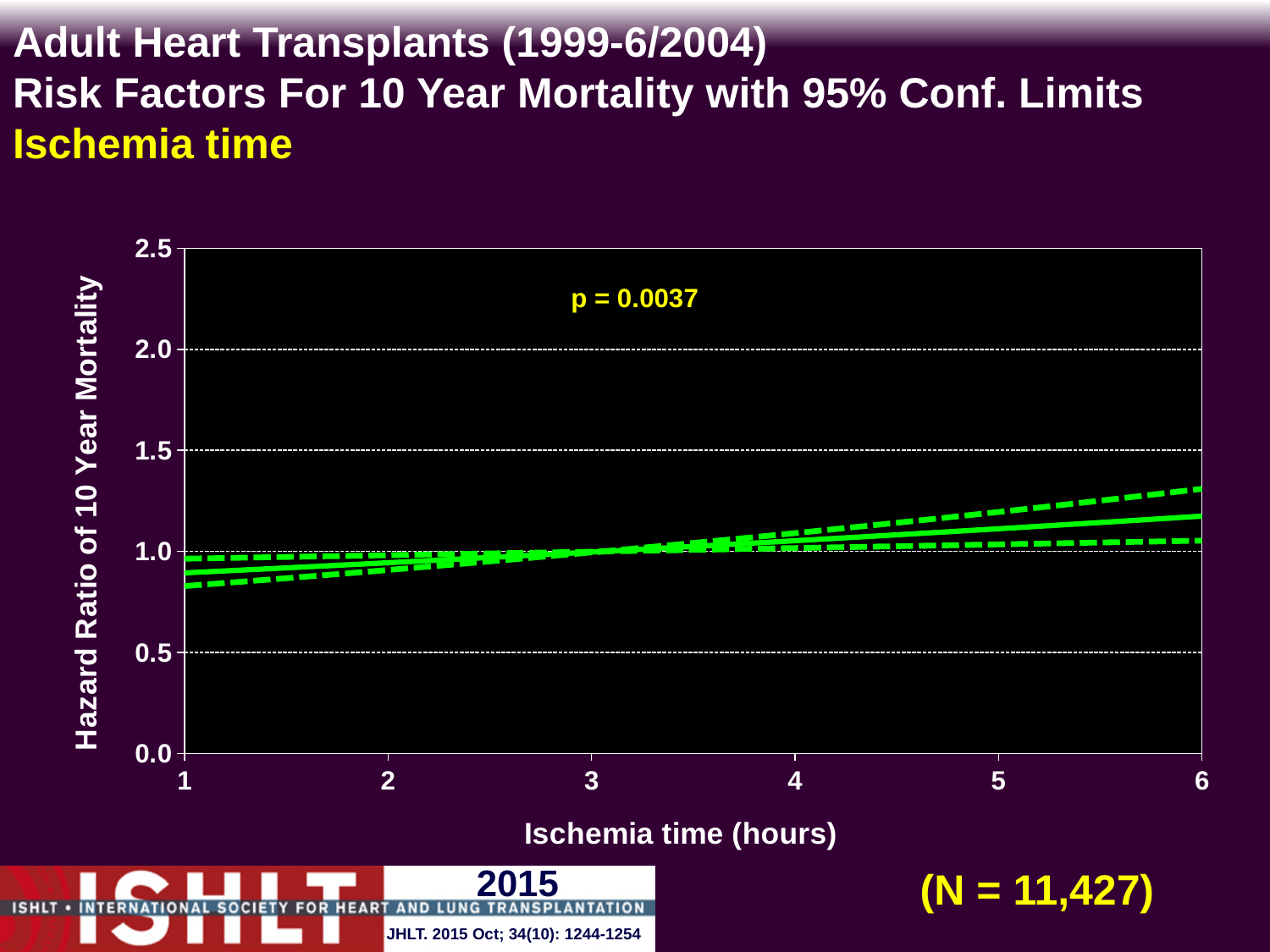
How many lines are plotted on the chart (the hazard ratio line plus its confidence limits)? 3 Is the hazard ratio at an ischemia time of 6 hours greater or less than 1.5? less What p-value is printed on the chart? p = 0.0037 Is the hazard ratio at an ischemia time of 1 hour greater or less than 1.0? less Is the lower 95% confidence limit at an ischemia time of 1 hour greater or less than 0.5? greater How many tick labels are shown on the x axis (Ischemia time in hours)? 6 What kind of chart is shown on the slide? line chart Is the hazard ratio higher at an ischemia time of 6 hours or at 1 hour? 6 hours What sample size (N) is shown on the slide? N = 11,427 Does the hazard ratio of 10 year mortality rise or fall as ischemia time increases from 1 to 6 hours? rise